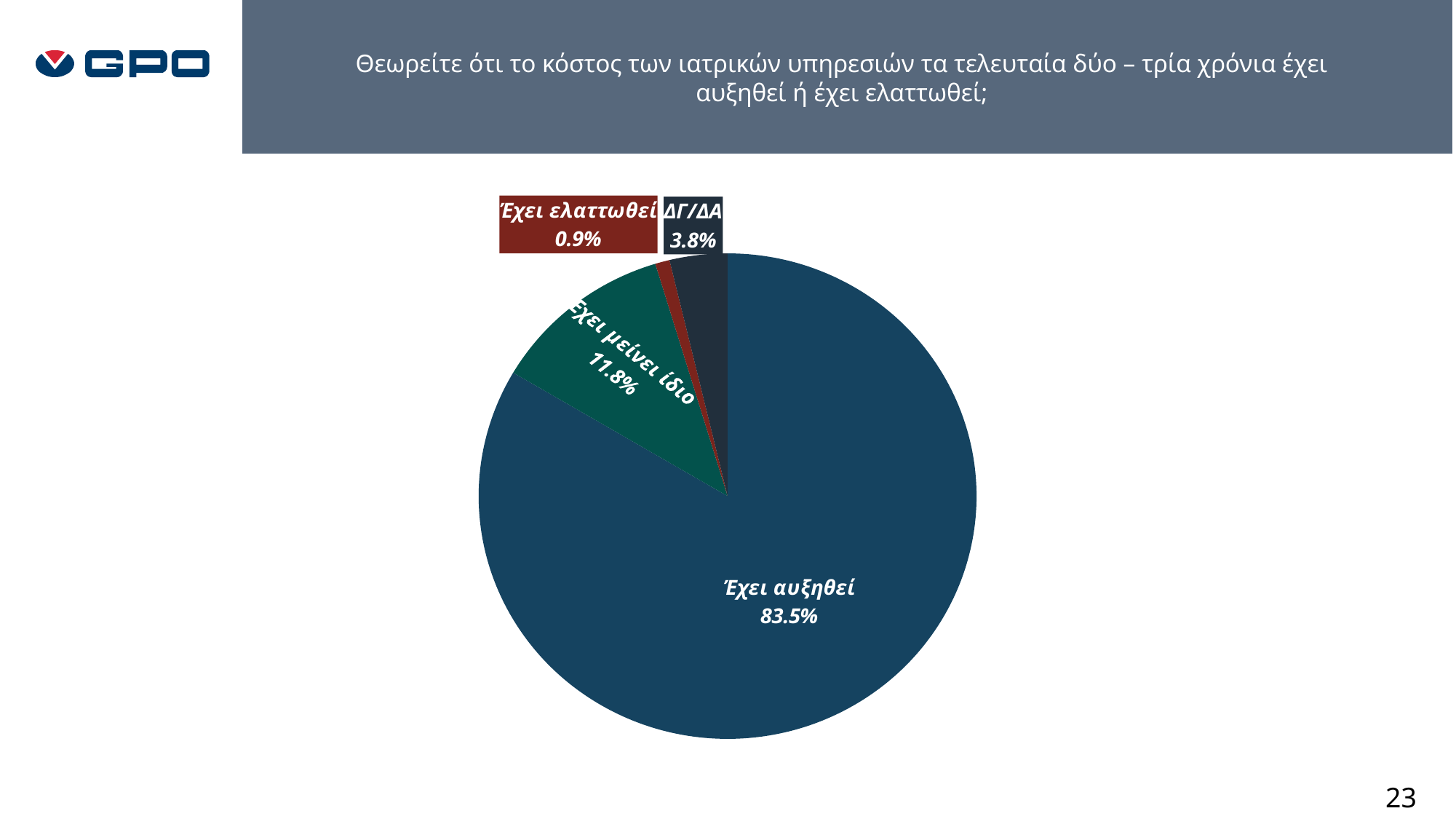
What is the difference in percentage points between 'Έχει αυξηθεί' and 'Έχει μείνει ίδιο'? 71.7 What is the difference in percentage points between 'ΔΓ/ΔΑ' and 'Έχει ελαττωθεί'? 2.9 Which response has the smallest share of the pie? Έχει ελαττωθεί What percentage of respondents answered 'Έχει αυξηθεί'? 83.5% Which is larger: the share for 'ΔΓ/ΔΑ' or the share for 'Έχει μείνει ίδιο'? Έχει μείνει ίδιο How many slices does the pie chart have? 4 What percentage of respondents answered 'ΔΓ/ΔΑ'? 3.8% What percentage of respondents answered 'Έχει μείνει ίδιο'? 11.8% What colour is the slice for 'Έχει μείνει ίδιο'? Green What percentage of respondents answered 'Έχει ελαττωθεί'? 0.9% Which response has the largest share of the pie? Έχει αυξηθεί What kind of chart is shown on the slide? Pie chart